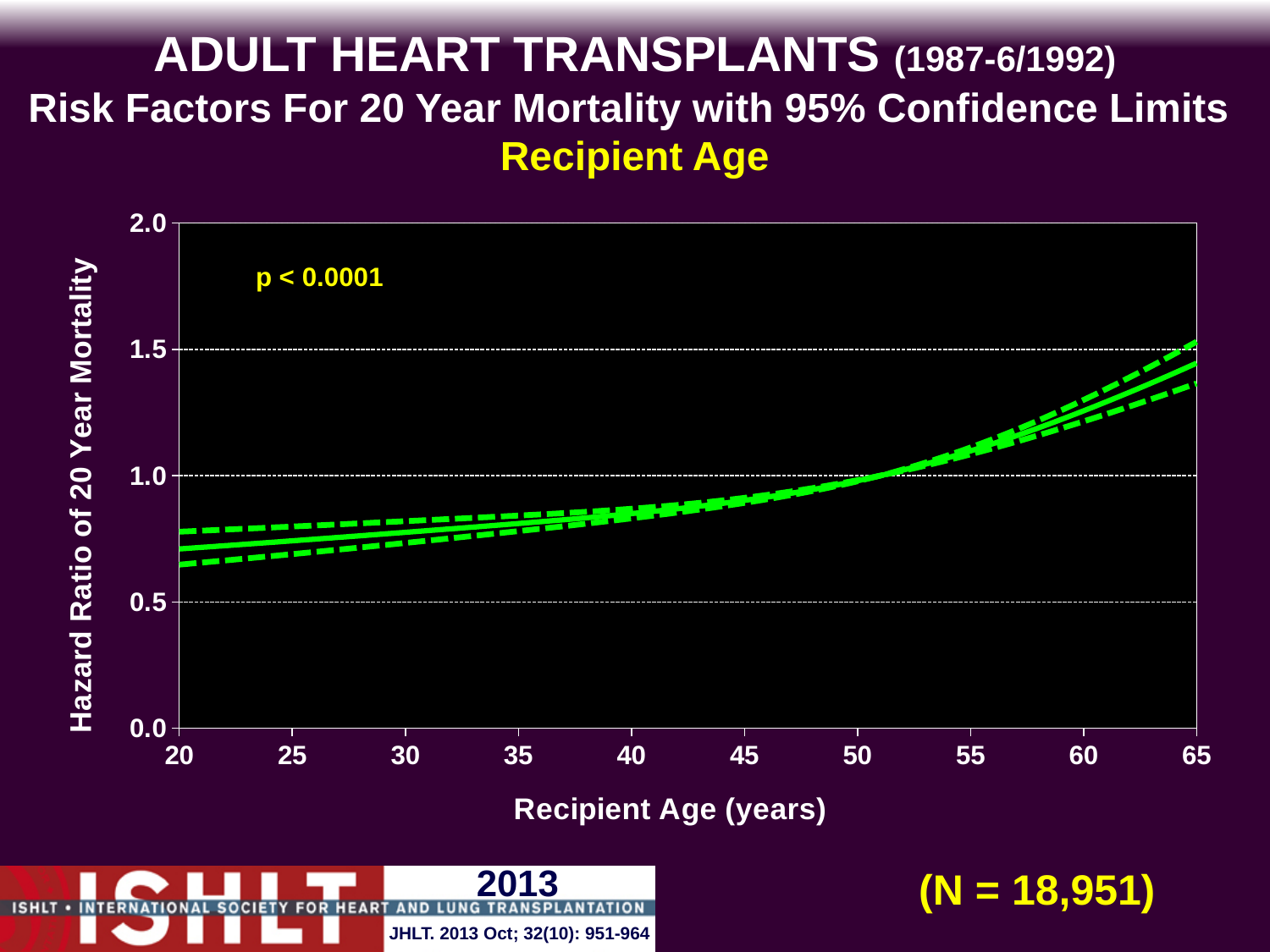
Is the hazard ratio for a recipient age of 20 years greater or less than 0.5? greater Is the hazard ratio for a recipient age of 40 years greater or less than 1.5? less Is the hazard ratio for a recipient age of 20 years greater or less than 1.0? less Does the hazard ratio of 20 year mortality rise or fall as recipient age increases from 20 to 65 years? rise What is the sample size (N) shown on the slide? N = 18,951 At which end of the recipient age axis is the hazard ratio lowest, 20 years or 65 years? 20 years What kind of chart is shown on the slide? line chart What p-value is printed on the chart? p < 0.0001 Which recipient age has the larger hazard ratio of 20 year mortality, 20 years or 65 years? 65 years